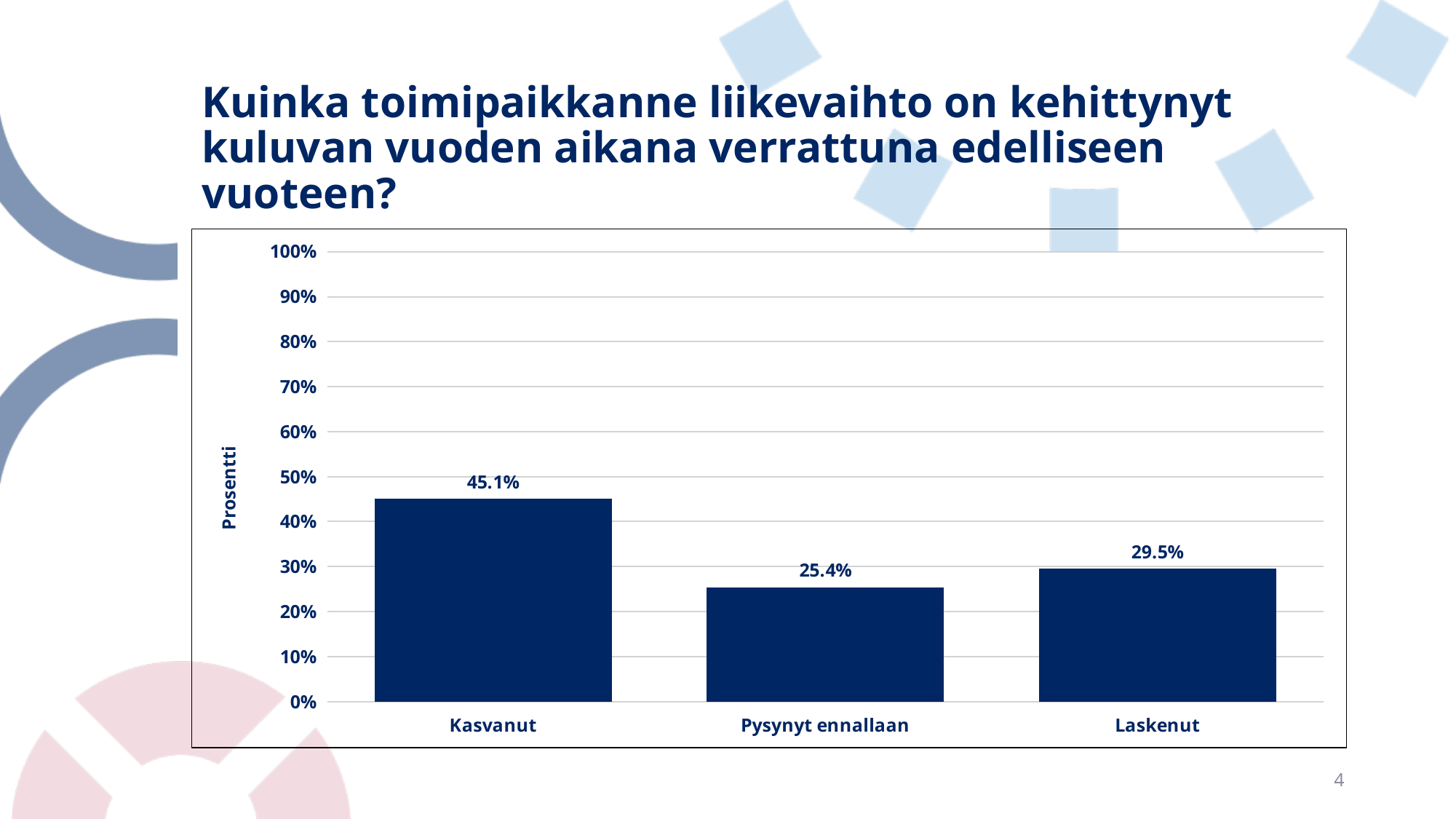
What is the value for Pysynyt ennallaan? 25.4% Which is larger, the value for Laskenut or the value for Pysynyt ennallaan? Laskenut What is the value for Laskenut? 29.5% Is the value for Kasvanut greater or less than 40%? greater What is the label of the y axis? Prosentti Which category has the lowest value? Pysynyt ennallaan Which category has the highest value? Kasvanut What kind of chart is shown on the slide? bar chart How many categories are shown on the x axis? 3 What is the value for Kasvanut? 45.1% What is the difference between the values for Laskenut and Pysynyt ennallaan? 4.1% What is the difference between the values for Kasvanut and Laskenut? 15.6%